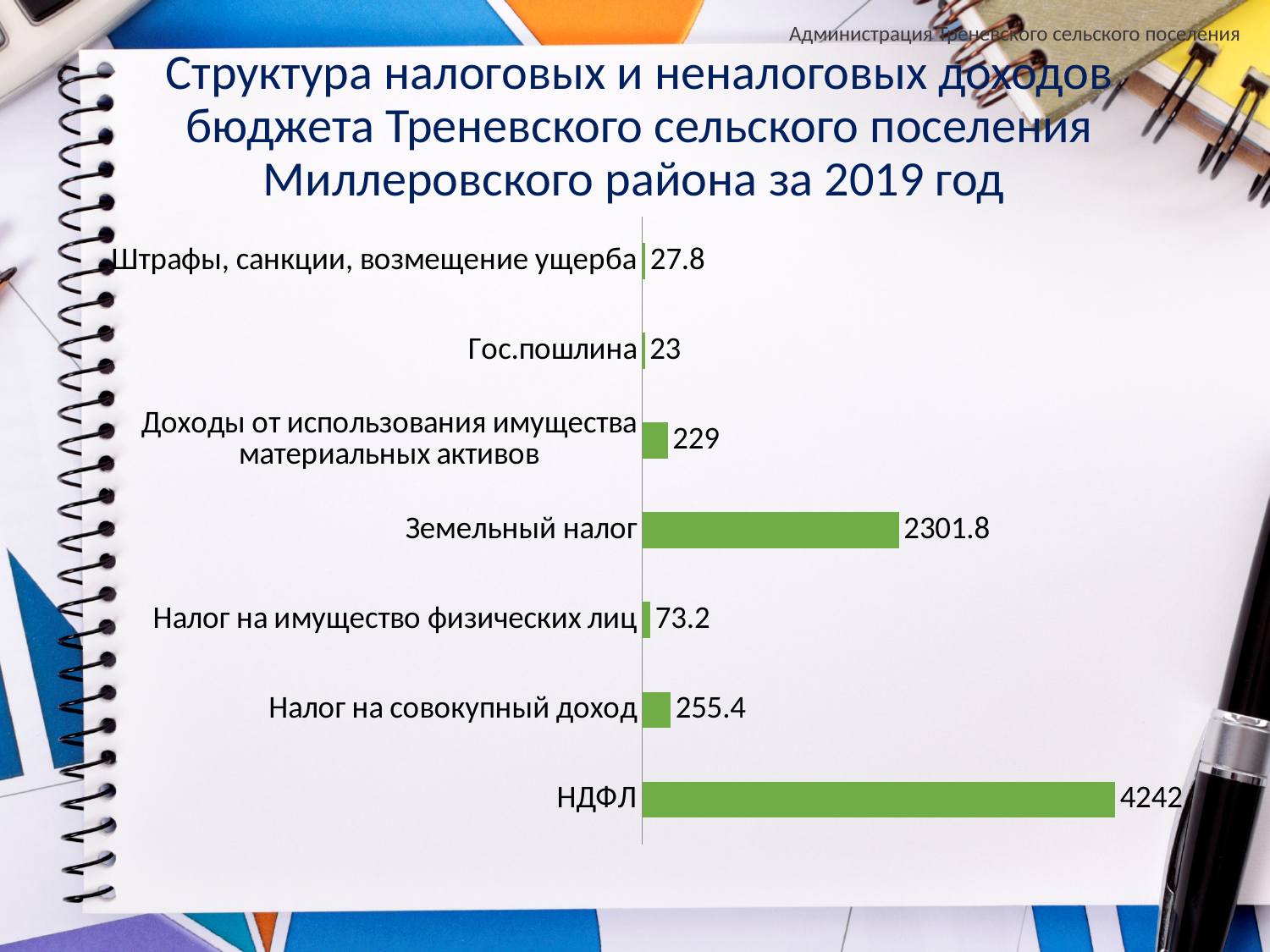
What is the difference between НДФЛ and Земельный налог? 1940.2 What is the value for Штрафы, санкции, возмещение ущерба? 27.8 Which is larger: Налог на совокупный доход or Доходы от использования имущества материальных активов? Налог на совокупный доход What is the difference between Налог на имущество физических лиц and Гос.пошлина? 50.2 What is the value for Земельный налог? 2301.8 How many categories are shown in the chart? 7 Which category has the lowest value? Гос.пошлина What is the value for Налог на совокупный доход? 255.4 What kind of chart is shown on the slide? Bar chart Which category has the highest value? НДФЛ What is the value for Гос.пошлина? 23 What is the value for НДФЛ? 4242